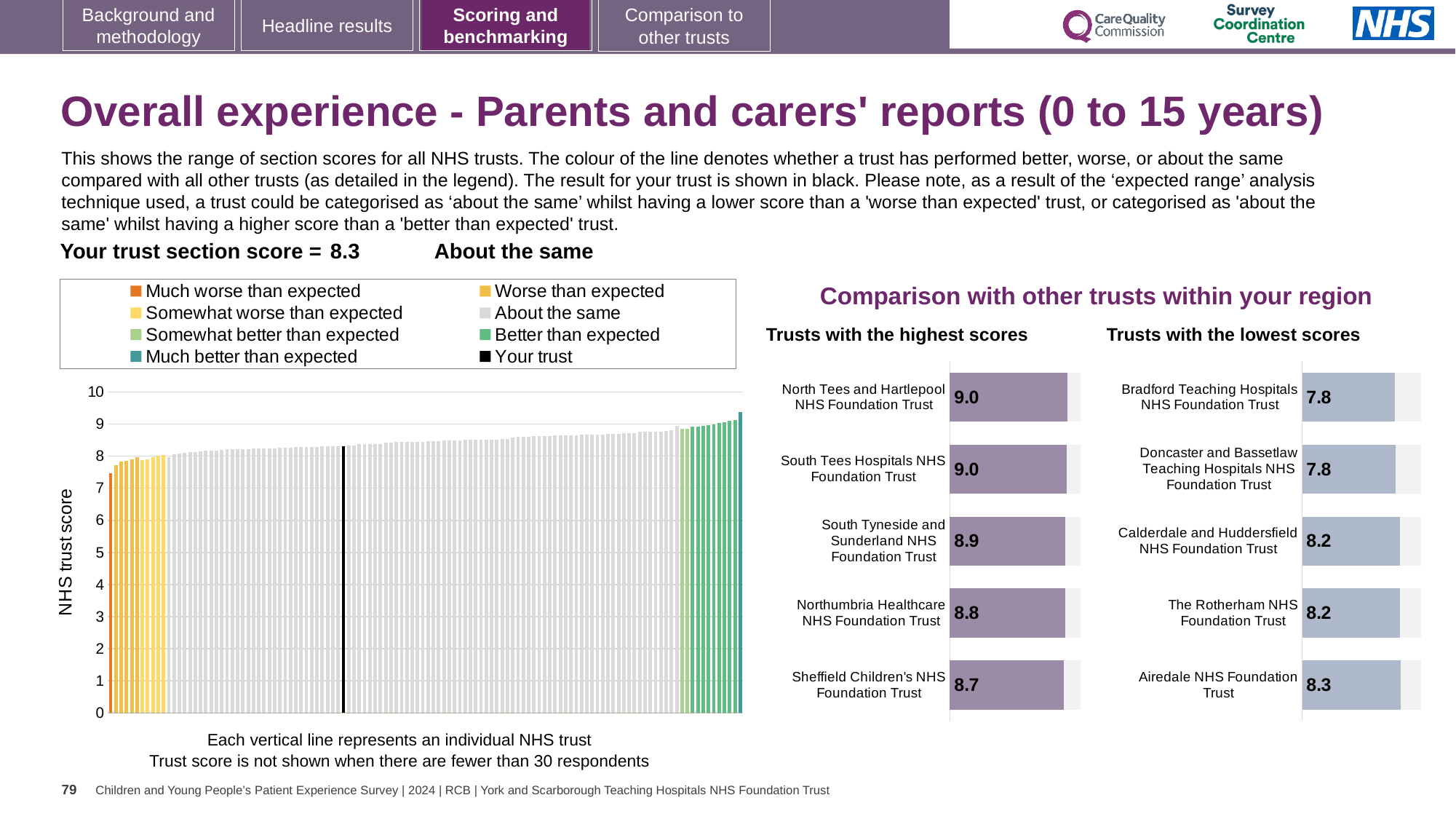
In the 'Trusts with the lowest scores' chart, what is the score for Calderdale and Huddersfield NHS Foundation Trust? 8.2 In the 'Trusts with the lowest scores' chart, which has the larger score: Calderdale and Huddersfield NHS Foundation Trust or Doncaster and Bassetlaw Teaching Hospitals NHS Foundation Trust? Calderdale and Huddersfield NHS Foundation Trust In the 'Trusts with the highest scores' chart, which trust has the lowest score? Sheffield Children's NHS Foundation Trust In the 'Trusts with the lowest scores' chart, what is the difference between the scores of Airedale NHS Foundation Trust and Bradford Teaching Hospitals NHS Foundation Trust? 0.5 How many entries does the legend of the main NHS trust score chart list? 8 In the 'Trusts with the highest scores' chart, what is the score for Northumbria Healthcare NHS Foundation Trust? 8.8 In the main NHS trust score chart on the left, is the value for the leftmost (orange) bar greater or less than 8? less In the 'Trusts with the lowest scores' chart, which trust has the highest score? Airedale NHS Foundation Trust In the 'Trusts with the highest scores' chart, what is the difference between the scores of North Tees and Hartlepool NHS Foundation Trust and Sheffield Children's NHS Foundation Trust? 0.3 How many trusts are shown in the 'Trusts with the highest scores' chart? 5 What kind of chart is the main NHS trust score chart on the left? bar chart In the main NHS trust score chart on the left, is the value for the black 'Your trust' bar greater or less than 8? greater